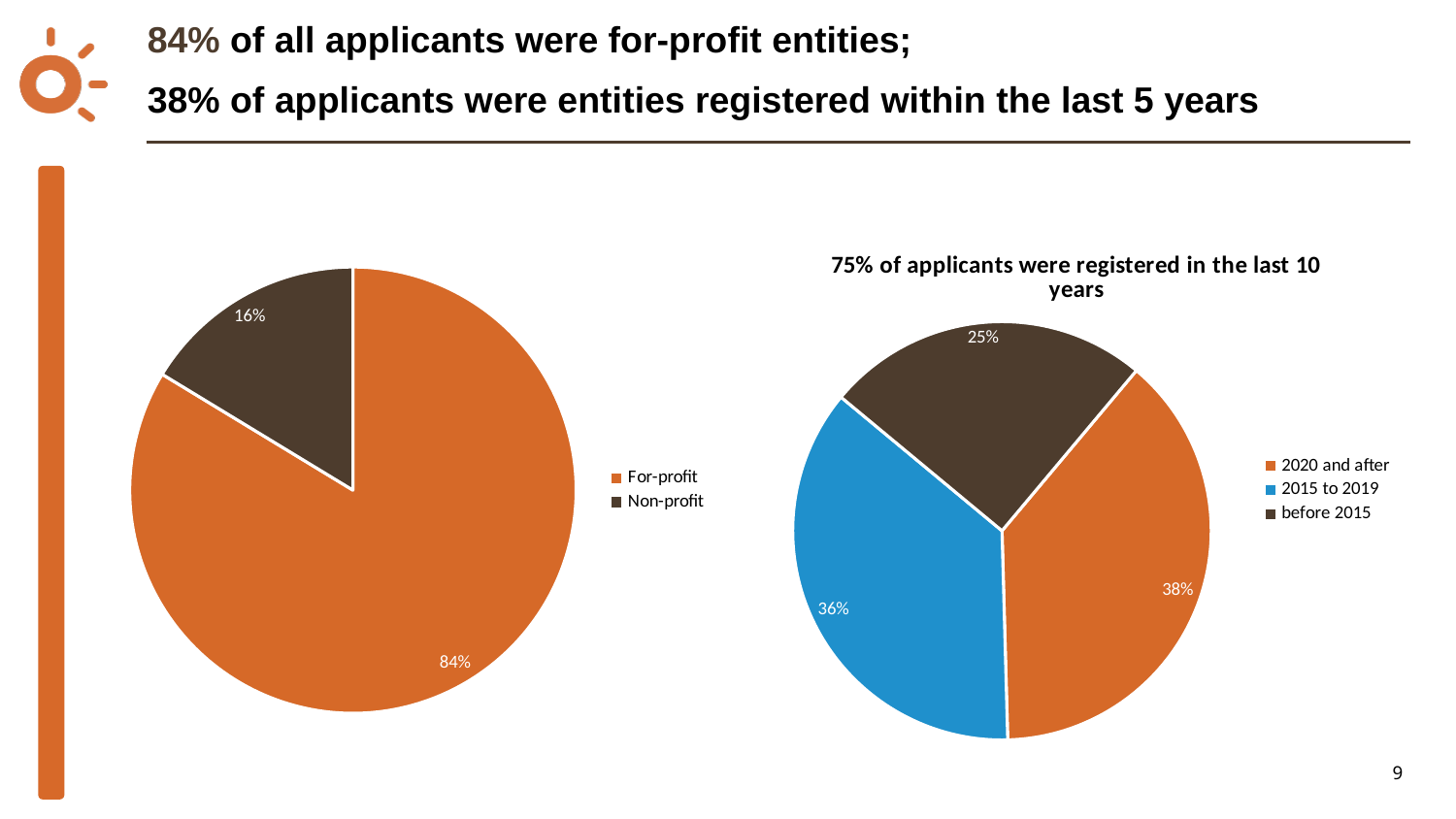
In the chart titled '75% of applicants were registered in the last 10 years', what share of applicants were registered in 2020 and after? 38% In the chart titled '75% of applicants were registered in the last 10 years', how many categories does the legend list? 3 In the left pie chart, what is the difference between the for-profit and non-profit shares? 68% In the left pie chart, what share of applicants were non-profit? 16% In the chart titled '75% of applicants were registered in the last 10 years', which category has the smallest slice? before 2015 In the left pie chart, which category has the larger slice? For-profit In the left pie chart, what share of applicants were for-profit? 84% In the chart titled '75% of applicants were registered in the last 10 years', what is the difference between the '2020 and after' share and the 'before 2015' share? 13% In the left pie chart, how many slices are there? 2 In the chart titled '75% of applicants were registered in the last 10 years', what share of applicants were registered before 2015? 25% What type of chart is the left chart on the slide? Pie chart In the chart titled '75% of applicants were registered in the last 10 years', what share of applicants were registered from 2015 to 2019? 36%